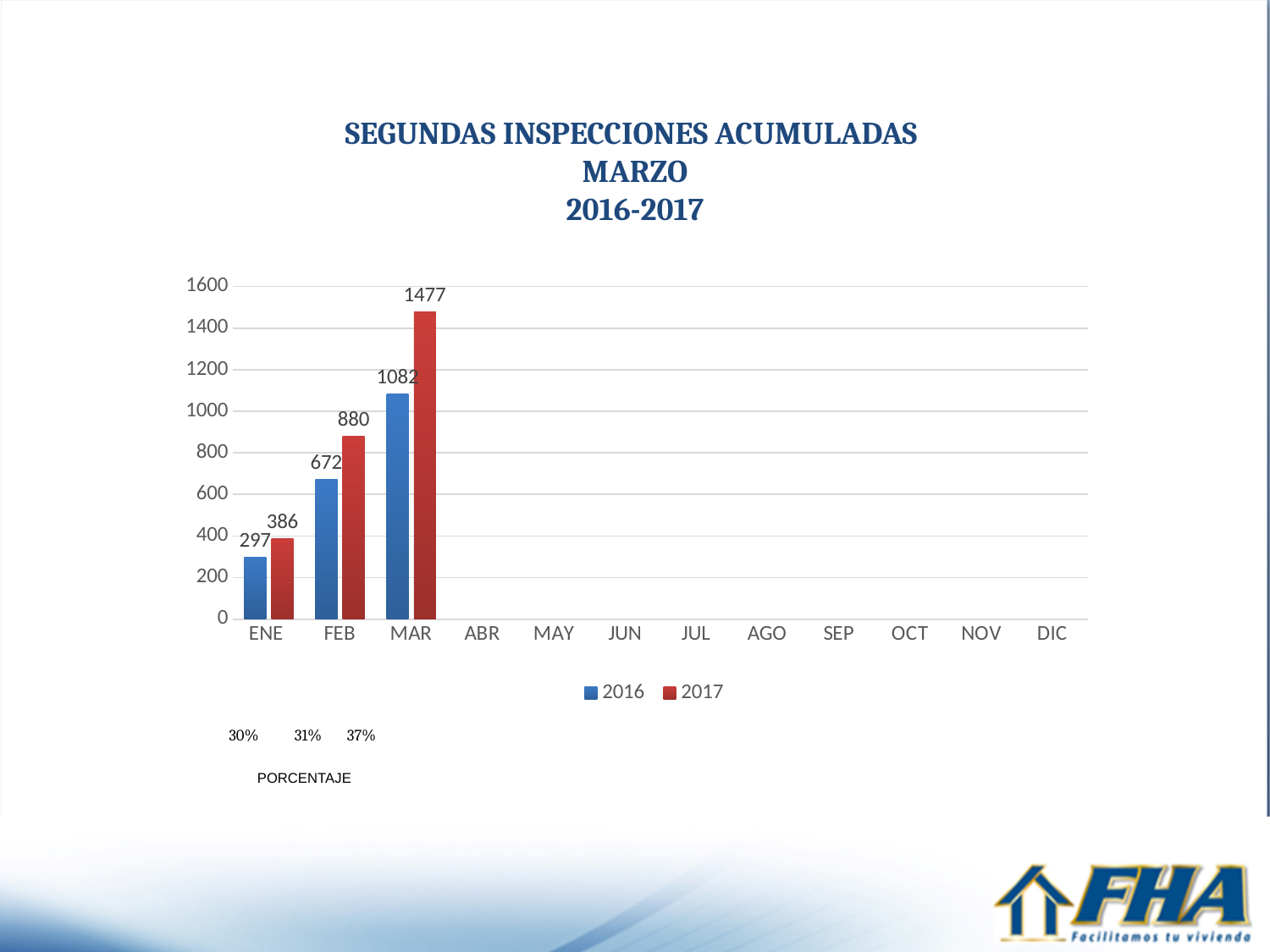
What is the value for 2017 in FEB? 880 How many series does the legend list? 2 What is the difference between the 2017 and 2016 values in ENE? 89 What kind of chart is shown on the slide? Bar chart Is the value for 2016 in FEB greater or less than 600? greater What is the value for 2017 in MAR? 1477 Which month has the lowest value for the 2016 series among the months with data? ENE Which month has the highest value for the 2017 series? MAR What is the difference between the 2017 and 2016 values in MAR? 395 Which is larger in FEB, the 2016 value or the 2017 value? 2017 What is the value for 2016 in MAR? 1082 What is the value for 2016 in ENE? 297